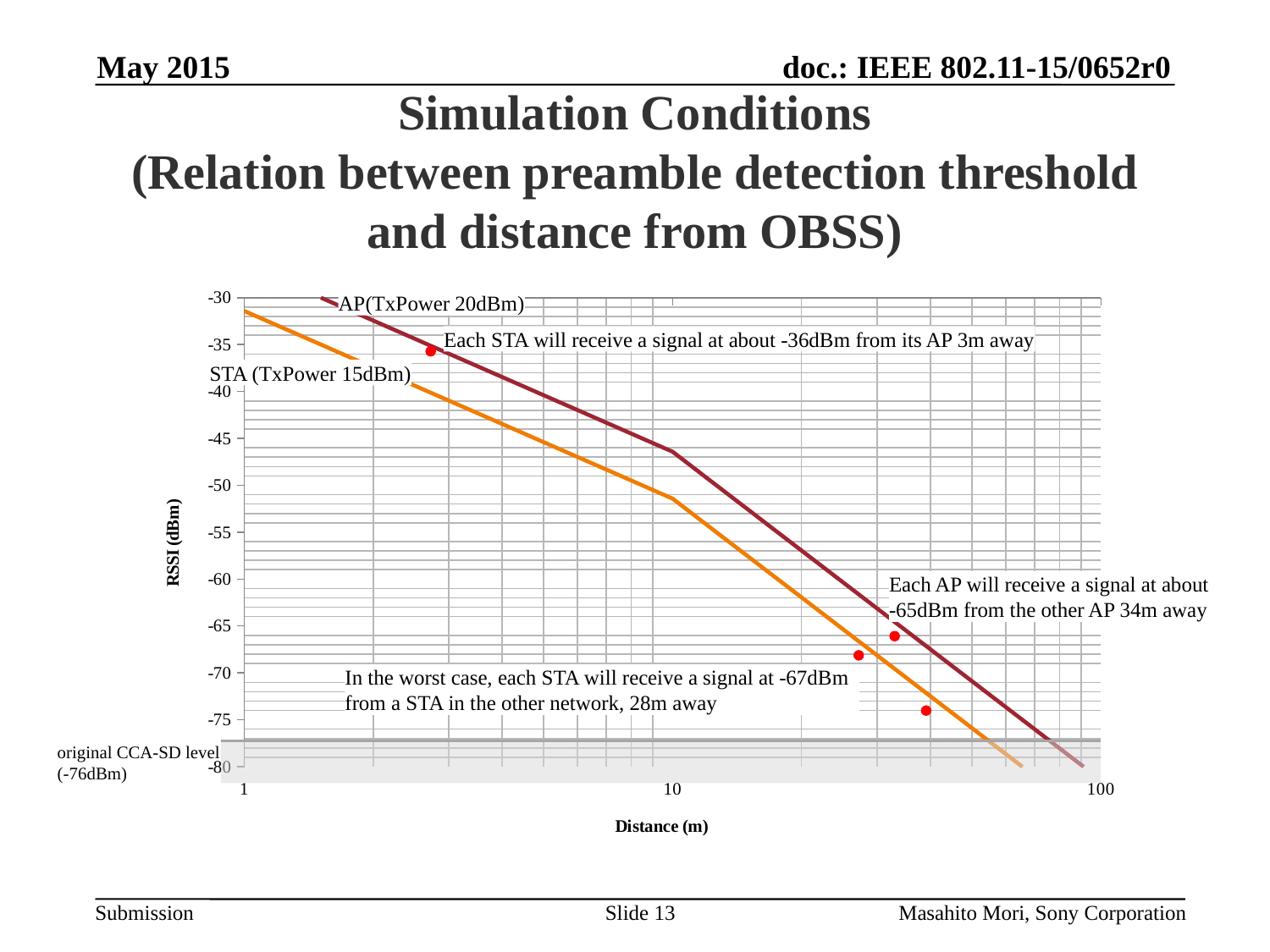
According to the annotation, in the worst case, at what RSSI will each STA receive a signal from a STA in the other network 28m away? -67dBm What is the original CCA-SD level marked on the chart? -76dBm According to the annotation, at what RSSI will each AP receive a signal from the other AP 34m away? -65dBm Is the RSSI of the STA (TxPower 15dBm) line at a distance of 10 m greater or less than -45 dBm? less What kind of chart is shown on the slide? line chart How many lines (series) are plotted on the chart? 2 Is the RSSI of the AP (TxPower 20dBm) line at a distance of 10 m greater or less than -50 dBm? greater What is the label of the x axis of the chart? Distance (m) According to the annotation, at what RSSI will each STA receive a signal from its AP 3m away? -36dBm What is the label of the y axis of the chart? RSSI (dBm) Which line is higher at any given distance, AP (TxPower 20dBm) or STA (TxPower 15dBm)? AP (TxPower 20dBm) Do the RSSI values rise or fall as distance increases along the x axis? fall